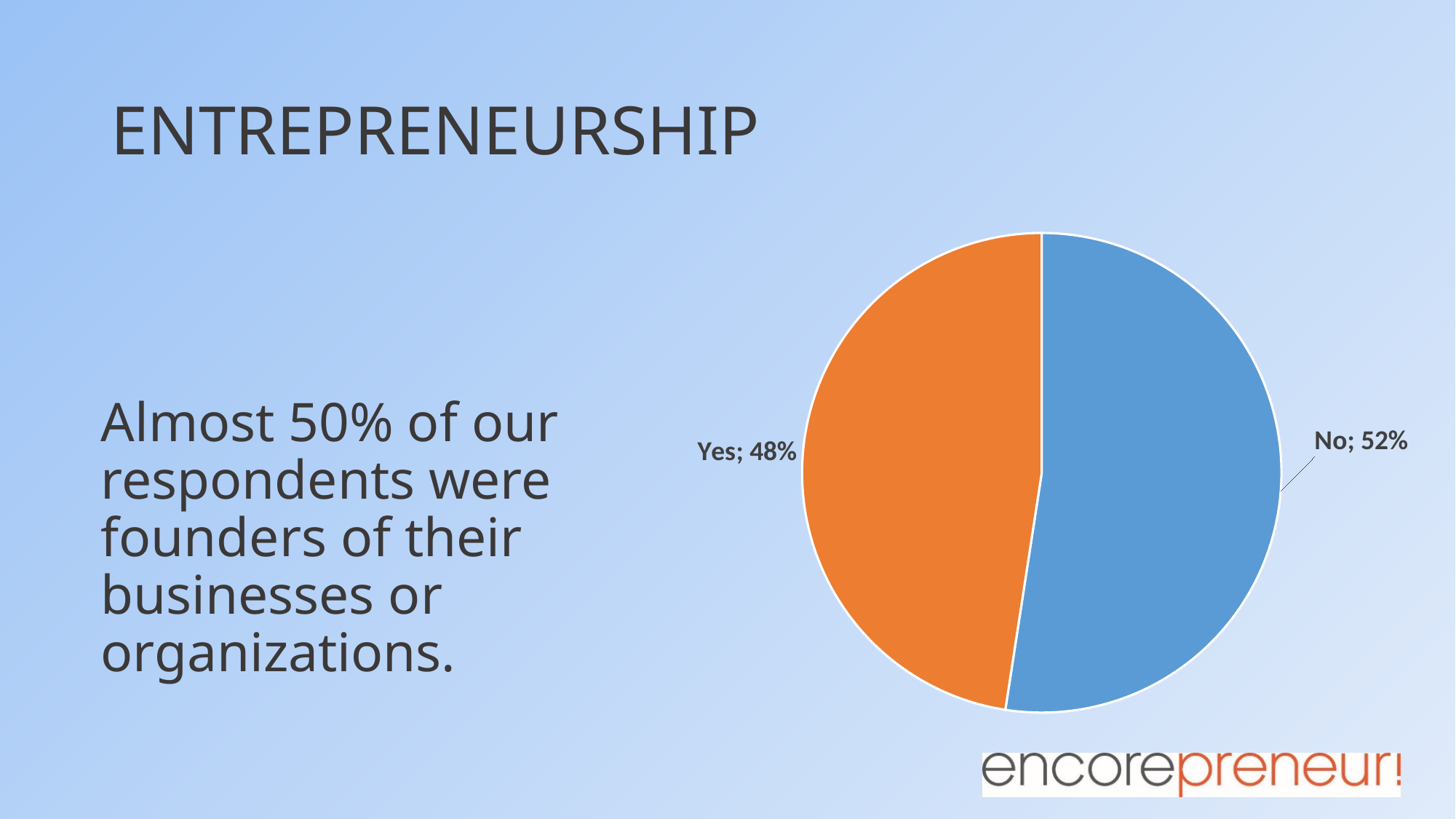
How many slices does the pie chart have? 2 What kind of chart is shown on the slide? pie chart What colour is the "No" slice of the pie? blue What share of the pie does the "Yes" slice represent? 48% What is the difference in percentage points between the "No" and "Yes" slices? 4 What colour is the "Yes" slice of the pie? orange Which is larger, the "Yes" slice or the "No" slice? No What percentage of respondents answered "No"? 52% Which slice of the pie is the smallest? Yes What percentage of respondents answered "Yes"? 48% Which slice of the pie is the largest? No